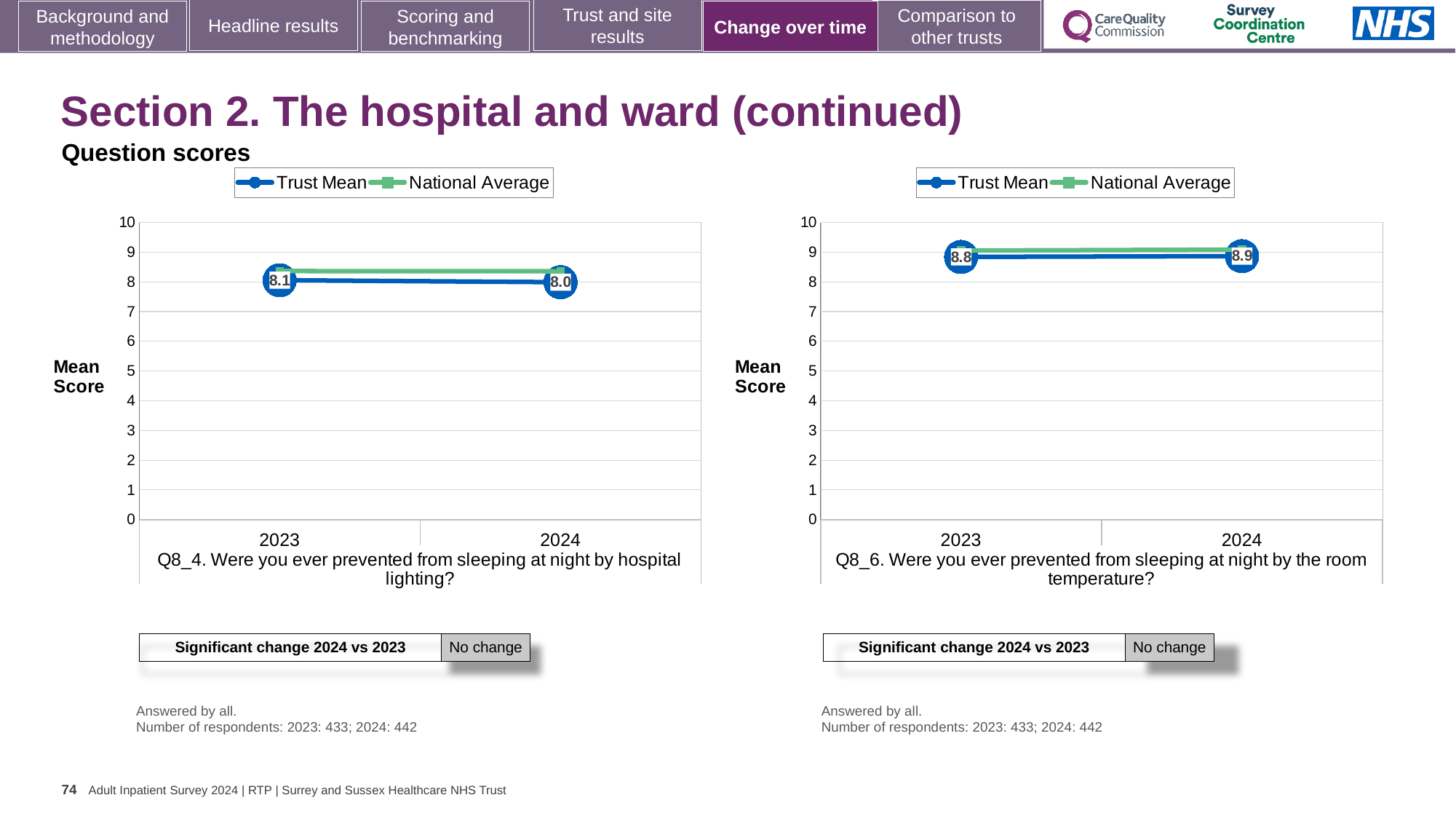
How many series does the legend of the Q8_4 chart (left) list? 2 What kind of chart is the Q8_6 chart (right)? line chart In the Q8_4 chart (left), what is the difference between the Trust Mean for 2023 and 2024? 0.1 In the Q8_4 chart (left), is the National Average for 2024 greater or less than 8? greater In the Q8_6 chart (right), what is the Trust Mean for 2023? 8.8 In the Q8_6 chart (right), what is the Trust Mean for 2024? 8.9 In the Q8_4 chart (left), what is the Trust Mean for 2024? 8.0 In the Q8_6 chart (right), which year has the higher Trust Mean, 2023 or 2024? 2024 In the Q8_6 chart (right), is the National Average for 2023 greater or less than 8? greater In the Q8_4 chart (left), does the Trust Mean rise or fall from 2023 to 2024? fall In the Q8_6 chart (right), does the Trust Mean rise or fall from 2023 to 2024? rise In the Q8_4 chart (left), what is the Trust Mean for 2023? 8.1